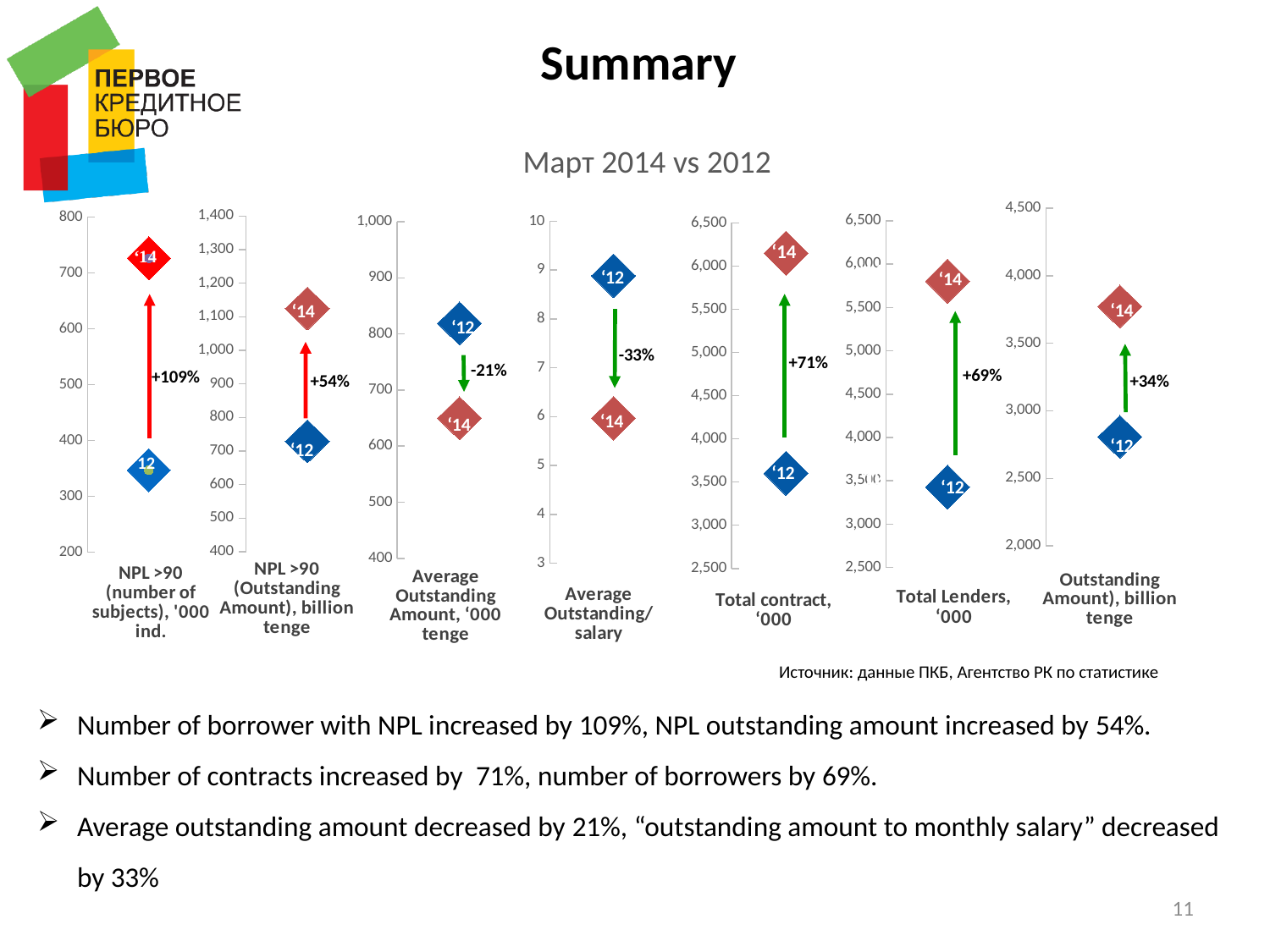
In the 'Total contract, '000' chart, is the value for '14 greater or less than 5,500? greater In the 'Average Outstanding/salary' chart, what percentage change is labelled? -33% In the 'NPL >90 (Outstanding Amount), billion tenge' chart, what percentage change is labelled? +54% In the 'Outstanding Amount), billion tenge' chart on the far right, what percentage change is labelled? +34% How many separate charts are shown on the slide? 7 In the 'Average Outstanding/salary' chart, is the value for '12 greater or less than 8? greater In the 'Total Lenders, '000' chart, is the value for '12 greater or less than 4,000? less In the 'NPL >90 (number of subjects), '000 ind.' chart, what percentage change is labelled between '12 and '14? +109% In the 'Total Lenders, '000' chart, what percentage change is labelled? +69% What is the subtitle shown above the charts? Март 2014 vs 2012 In the 'Average Outstanding Amount, '000 tenge' chart, which year has the higher value, '12 or '14? '12